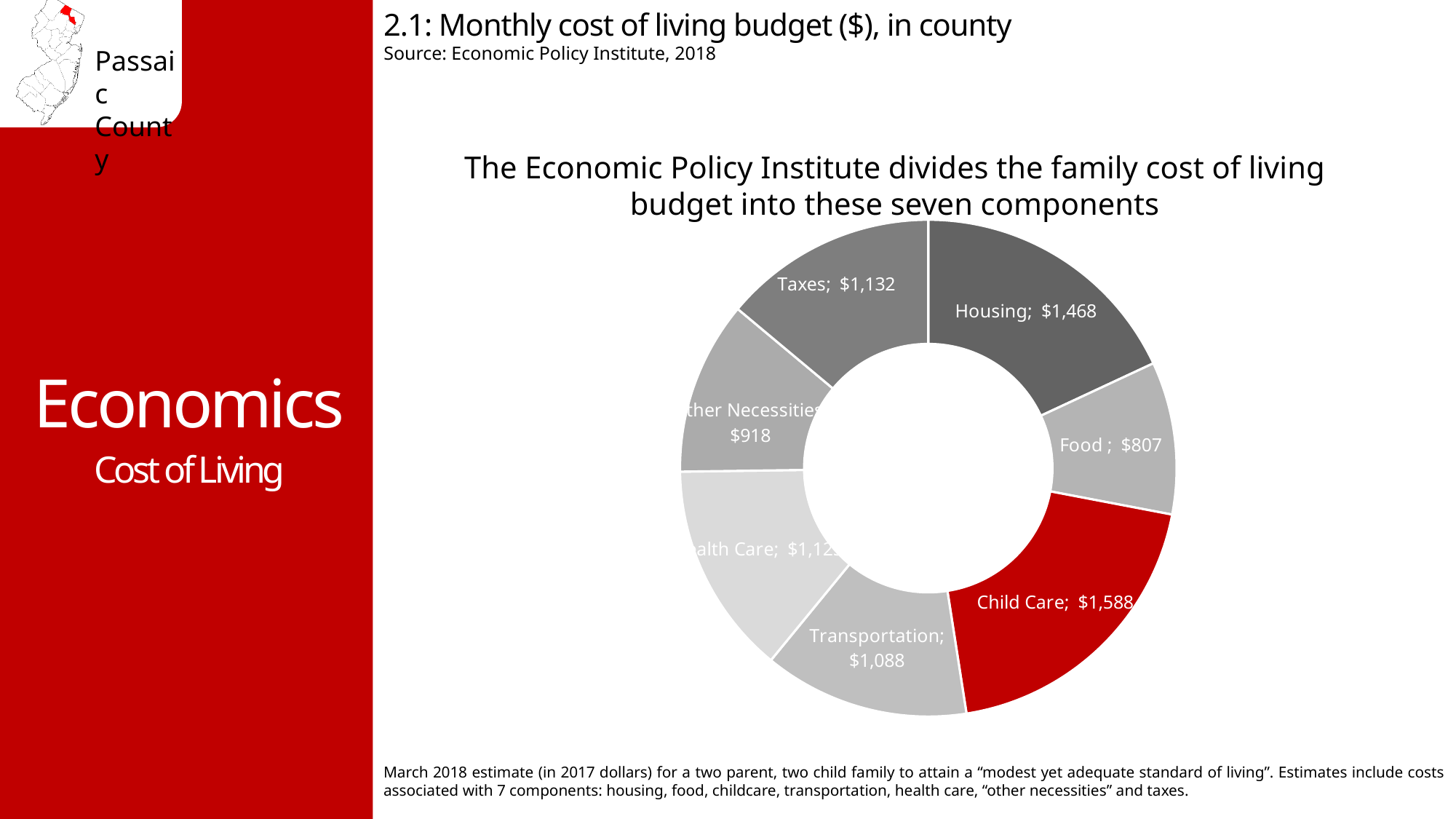
Which is larger, the cost for Taxes or the cost for Transportation? Taxes What is the difference between the Child Care and Housing costs? $120 What is the monthly cost for Taxes? $1,132 Which component has the lowest monthly cost? Food What is the monthly cost for Food? $807 What is the monthly cost for Housing? $1,468 What is the monthly cost for Child Care? $1,588 How many components are shown in the chart? 7 Which component has the highest monthly cost? Child Care What is the monthly cost for Transportation? $1,088 What is the difference between the Housing and Food costs? $661 What kind of chart is shown on the slide? Doughnut (pie) chart